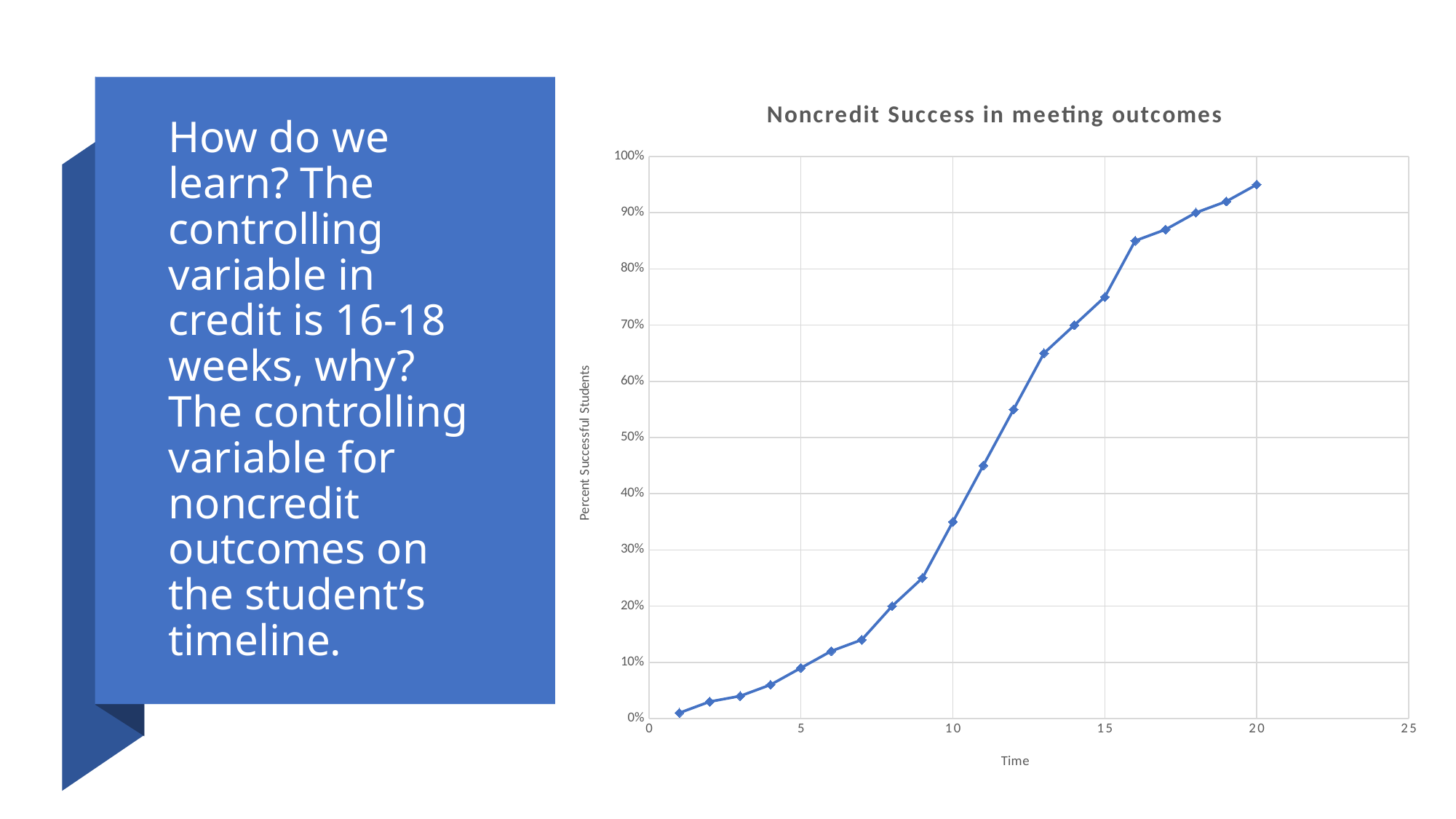
Do the values rise or fall as Time increases along the x axis? rise How many data points are plotted on the line? 20 What is the title of the chart? Noncredit Success in meeting outcomes What kind of chart is shown on the slide? line chart What is the label of the vertical axis of the chart? Percent Successful Students Is the value at Time 20 greater or less than 90%? greater Which Time value has the lowest percent of successful students? 1 Which Time value has the highest percent of successful students? 20 Is the value at Time 12 greater or less than 60%? less Is the value at Time 10 greater or less than 30%? greater